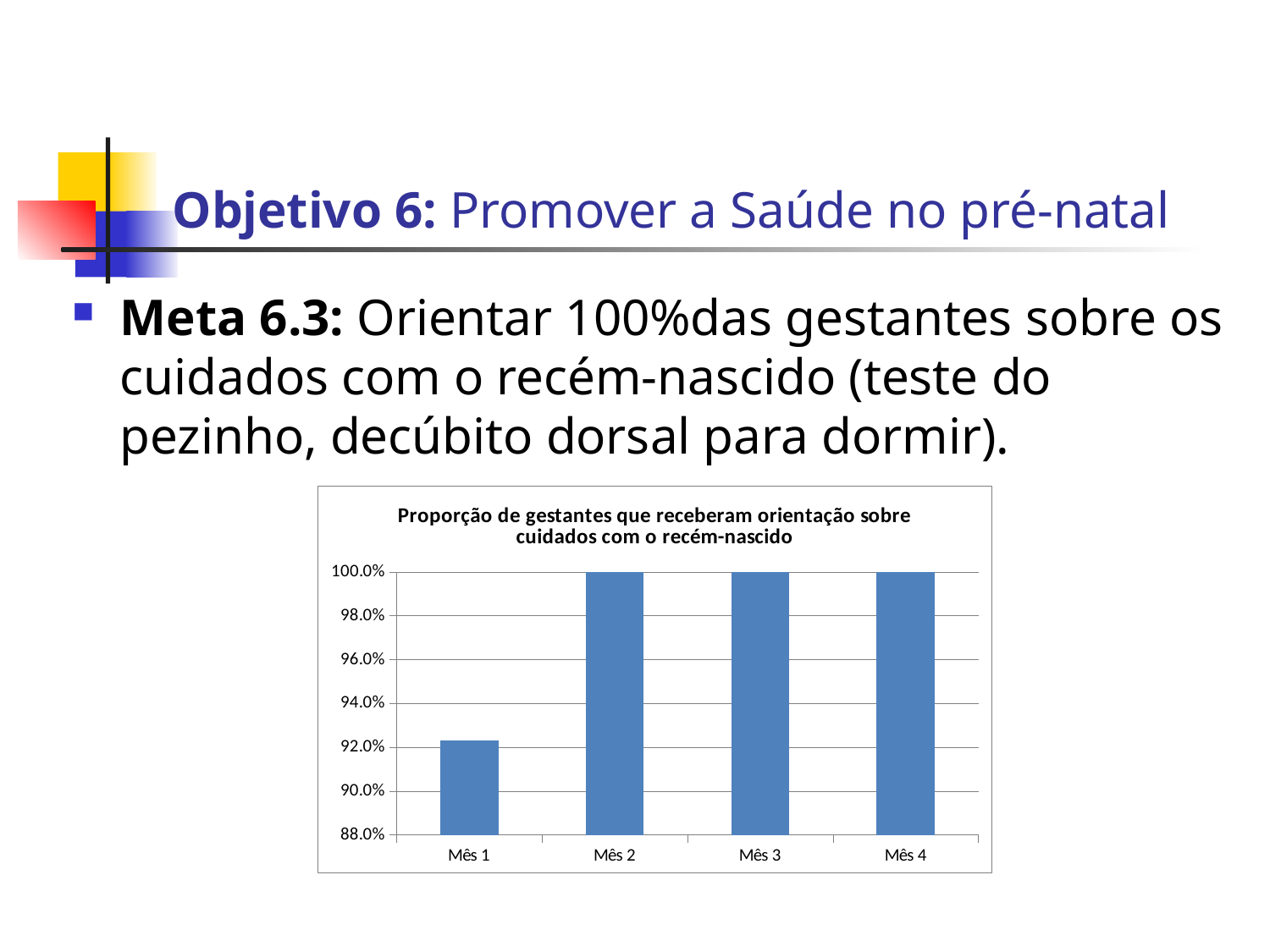
Does the value rise or fall from Mês 1 to Mês 2? rise Is the value for Mês 1 greater or less than 90.0%? greater What is the value for Mês 3? 100.0% What is the value for Mês 4? 100.0% What is the title of the chart? Proporção de gestantes que receberam orientação sobre cuidados com o recém-nascido Which is larger, the value for Mês 1 or the value for Mês 2? Mês 2 What kind of chart is shown on the slide? bar chart How many months (categories) are shown on the x axis of the chart? 4 Which month has the lowest value? Mês 1 What is the difference between the values for Mês 2 and Mês 4? 0.0% What is the value for Mês 2? 100.0% Is the value for Mês 1 greater or less than 94.0%? less